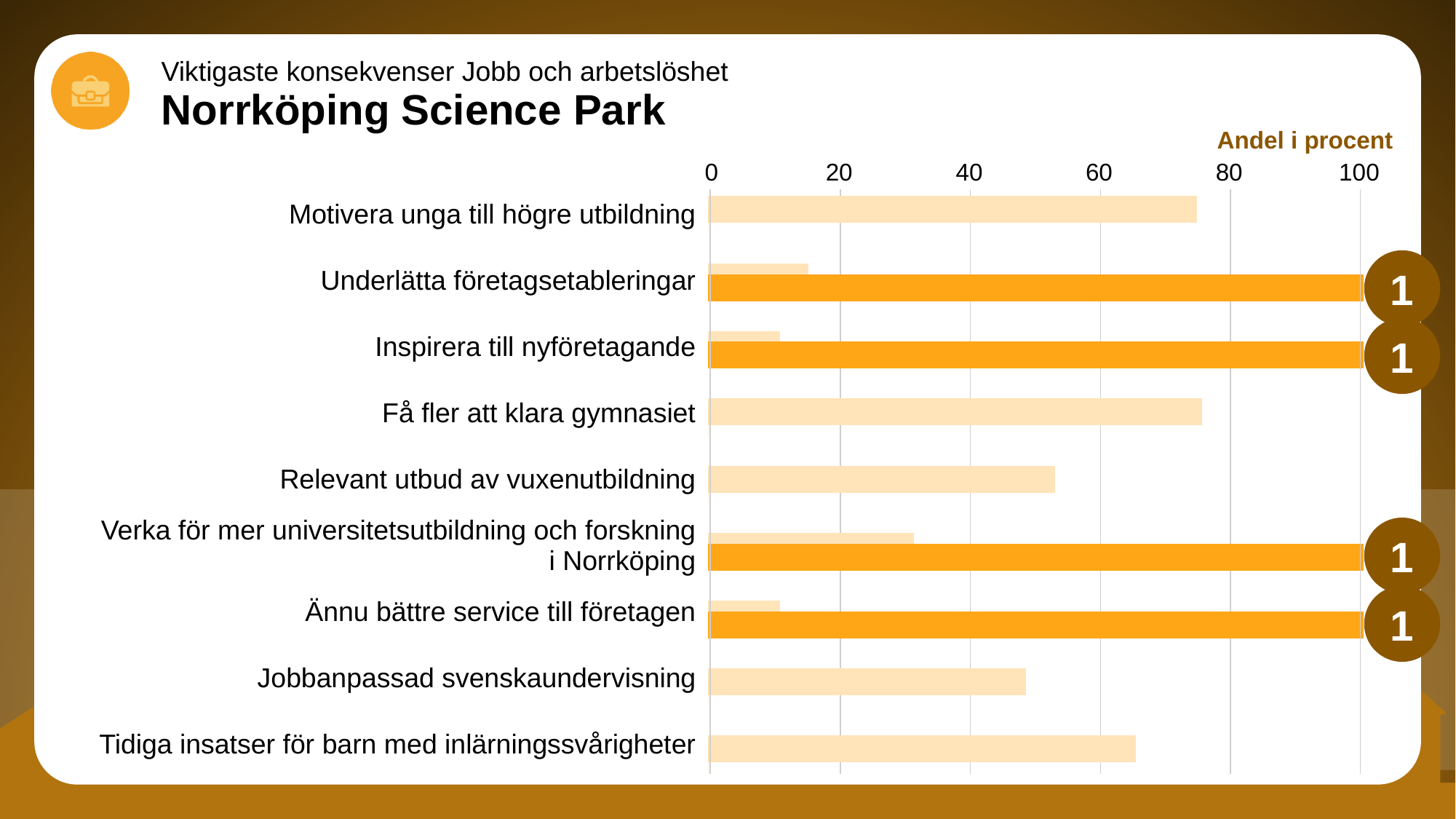
Which has a larger value: 'Tidiga insatser för barn med inlärningssvårigheter' or 'Jobbanpassad svenskaundervisning'? Tidiga insatser för barn med inlärningssvårigheter Is the value for 'Relevant utbud av vuxenutbildning' greater or less than 60? less Which has a larger value: 'Få fler att klara gymnasiet' or 'Relevant utbud av vuxenutbildning'? Få fler att klara gymnasiet Is the value for 'Motivera unga till högre utbildning' greater or less than 60? greater Is the value for 'Tidiga insatser för barn med inlärningssvårigheter' greater or less than 80? less How many categories have a dark orange bar in addition to the light orange bar? 4 What kind of chart is shown on the slide? bar chart How many categories are listed on the chart? 9 What label is shown above the horizontal axis of the chart? Andel i procent